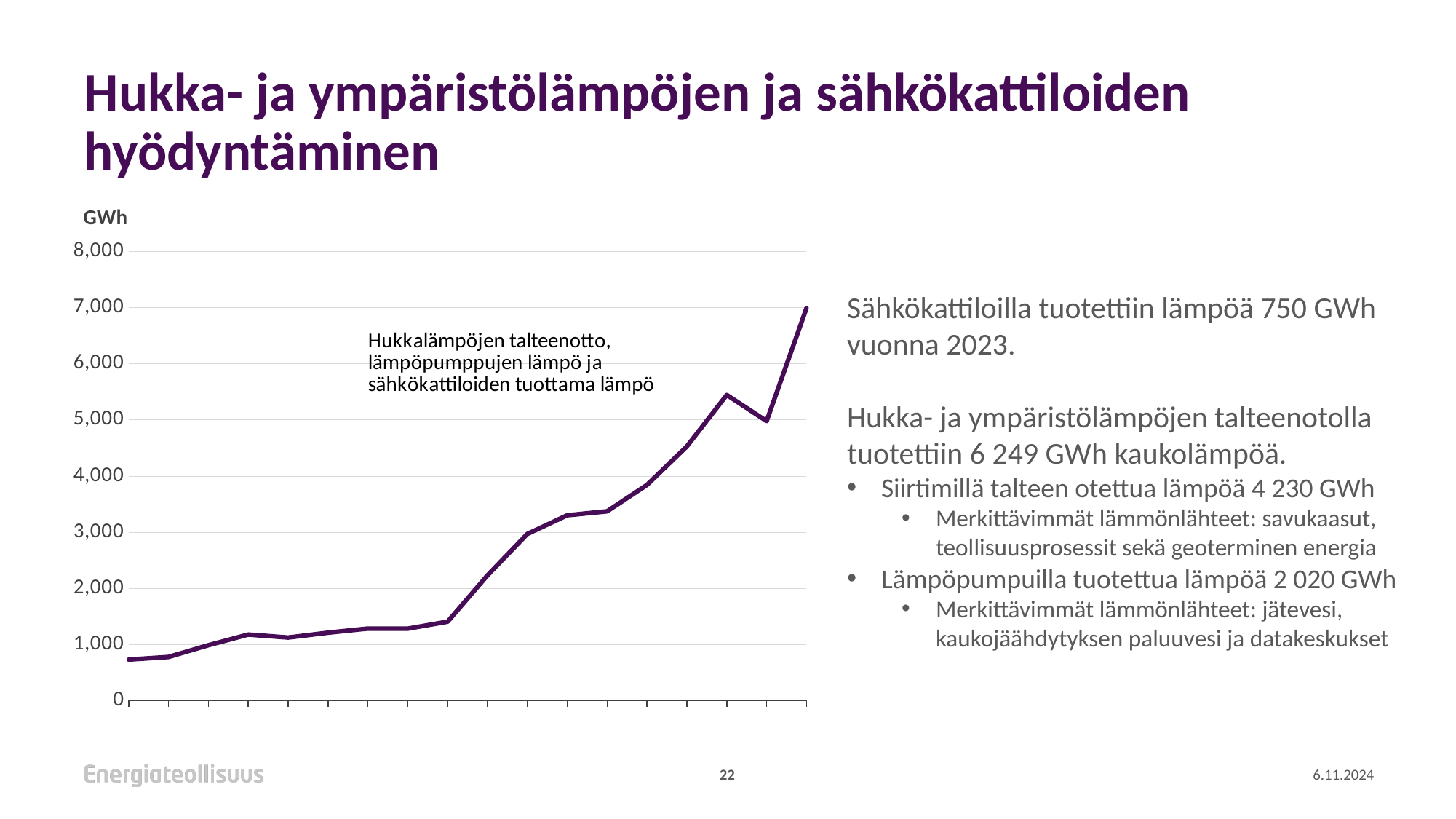
Is the value at the first (leftmost) point of the line greater or less than 1,000? less How many data series does the chart plot? 1 What is the label of the plotted series on the chart? Hukkalämpöjen talteenotto, lämpöpumppujen lämpö ja sähkökattiloiden tuottama lämpö Which point on the line has the highest value, the leftmost or the rightmost? the rightmost Do the values in the chart generally rise or fall from left to right? rise Is the highest value on the chart greater or less than 6,000? greater Which point on the line has the lowest value, the leftmost or the rightmost? the leftmost What unit is shown on the chart's vertical axis? GWh What kind of chart is shown on the slide? line chart Is the lowest value on the chart greater or less than 1,000? less What is the highest value shown on the chart's vertical axis? 8,000